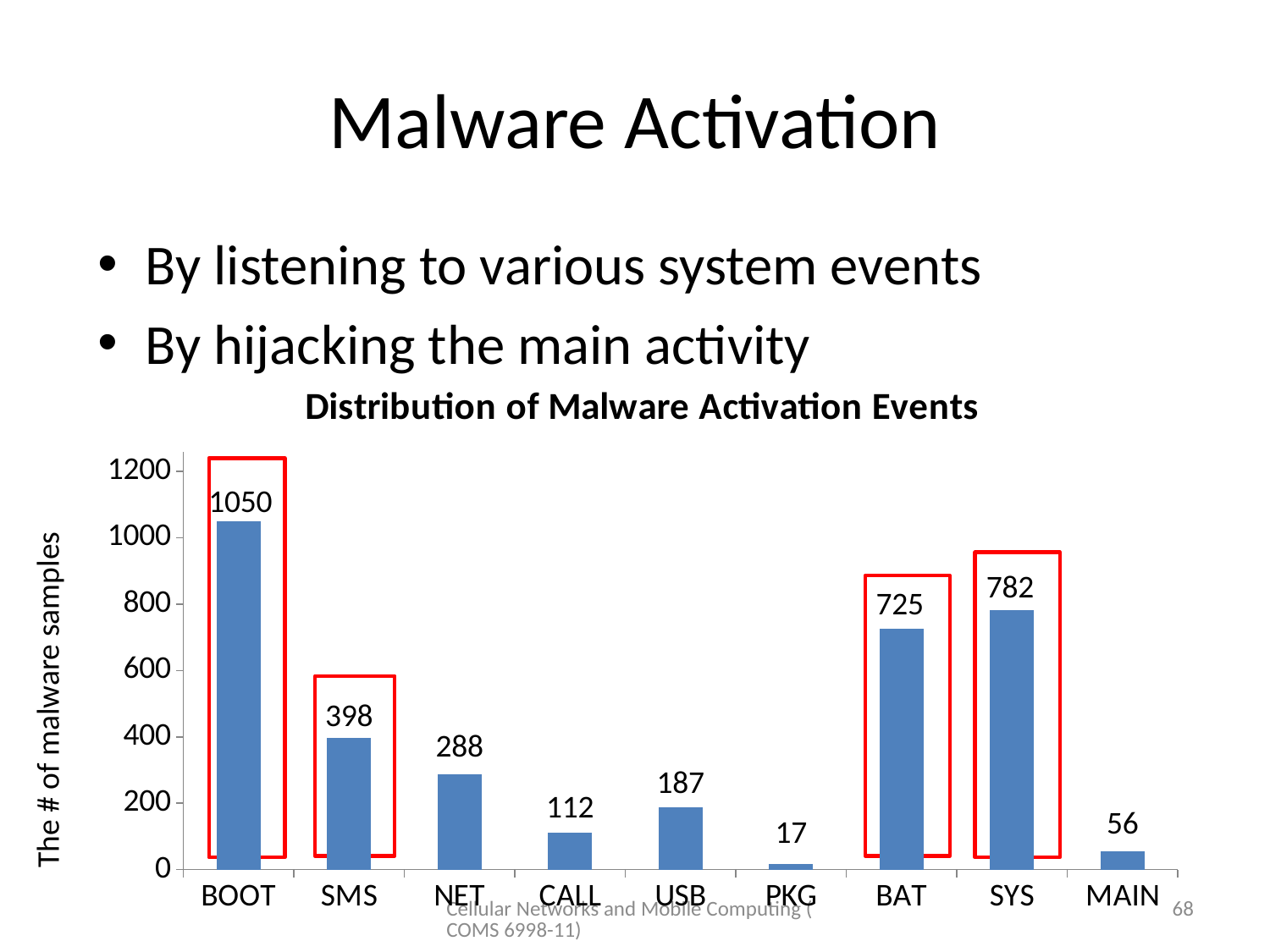
How many categories are shown on the x axis? 9 What is the value for PKG? 17 What is the difference between the values for SYS and BAT? 57 What kind of chart is shown on the slide? bar chart Which is larger, the value for SMS or the value for NET? SMS What is the value for SYS? 782 What is the title of the chart? Distribution of Malware Activation Events Is the value for USB greater or less than 200? less What is the value for BOOT in the Distribution of Malware Activation Events chart? 1050 Which category has the highest value? BOOT What is the label of the y axis? The # of malware samples Which category has the lowest value? PKG